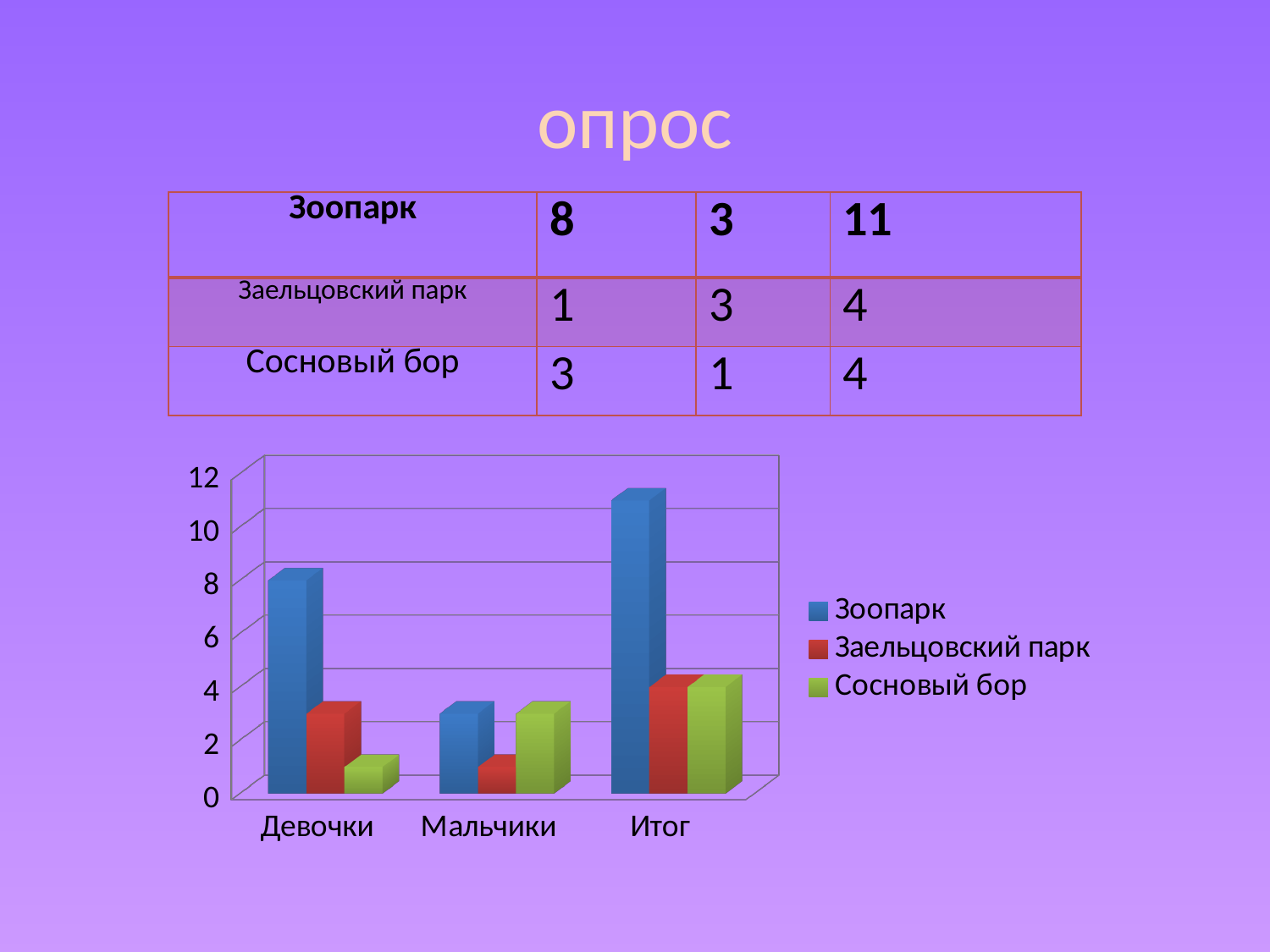
What is the value of the Заельцовский парк bar for Итог? 4 Which bar in the chart is the tallest overall? Зоопарк for Итог How many series does the chart legend list? 3 Which is larger: the Зоопарк bar for Девочки or the Зоопарк bar for Мальчики? Девочки Within the Девочки category, which series has the lowest bar? Сосновый бор Within the Мальчики category, which is larger: Сосновый бор or Заельцовский парк? Сосновый бор Is the value of the Зоопарк bar for Итог greater or less than 10? greater What colour represents the Зоопарк series in the chart? blue What kind of chart is shown on the slide? bar chart Is the value of the Зоопарк bar for Мальчики greater or less than 4? less How many categories are shown along the x axis of the chart? 3 What is the value of the Зоопарк bar for Девочки? 8